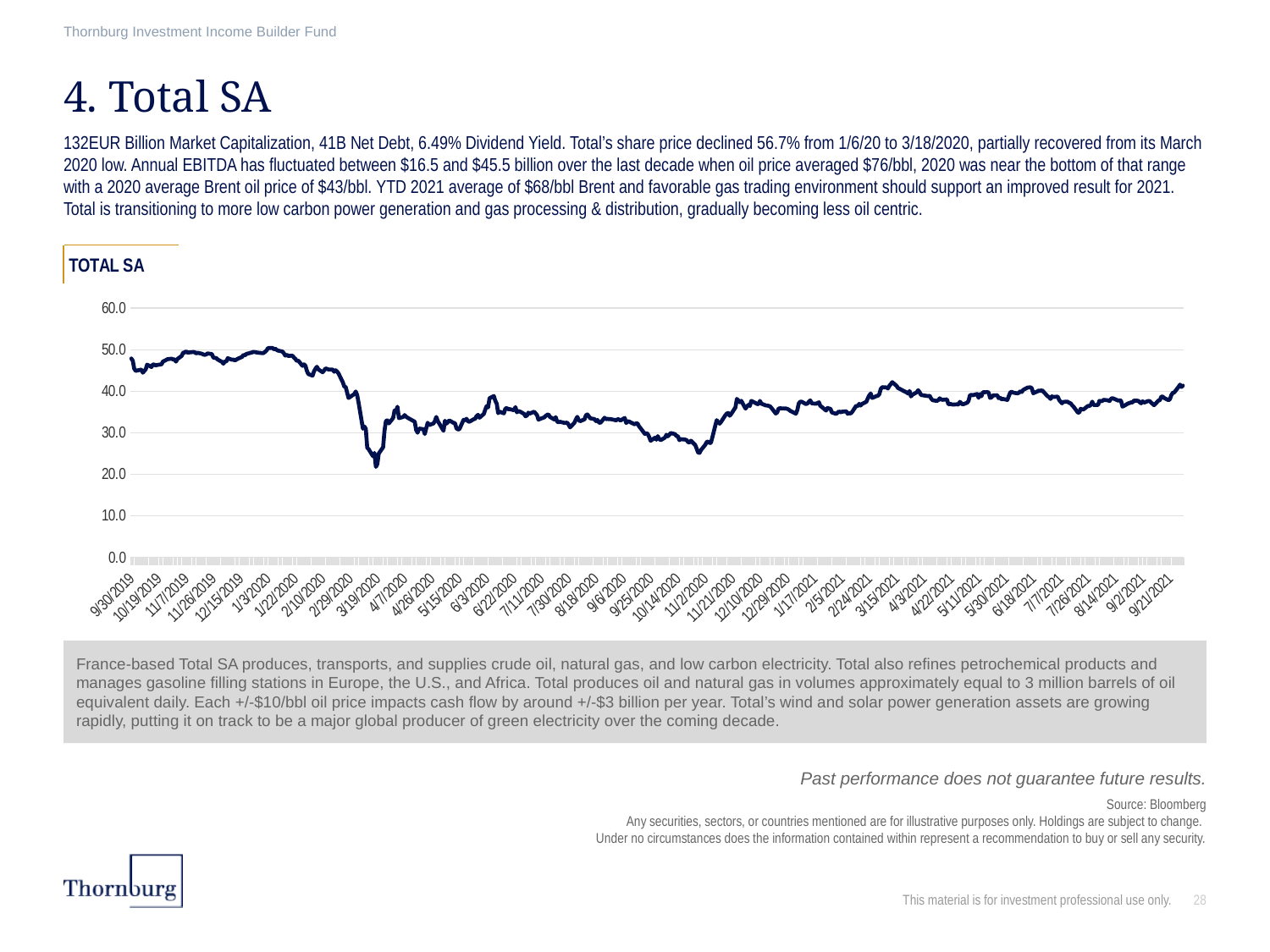
Is the value for 9/21/2021 greater or less than 30.0? greater Is the value for 9/30/2019 greater or less than 40.0? greater Around which date on the x axis does the line reach its lowest point? 3/19/2020 What is the title of the chart? TOTAL SA Does the line rise or fall between 1/3/2020 and 3/19/2020? fall What kind of chart is shown on the slide? line chart Is the value for 11/2/2020 greater or less than 30.0? less Does the line rise or fall between 11/2/2020 and 3/15/2021? rise What is the highest value shown on the vertical axis of the chart? 60.0 Which is larger, the value for 9/30/2019 or the value for 9/21/2021? 9/30/2019